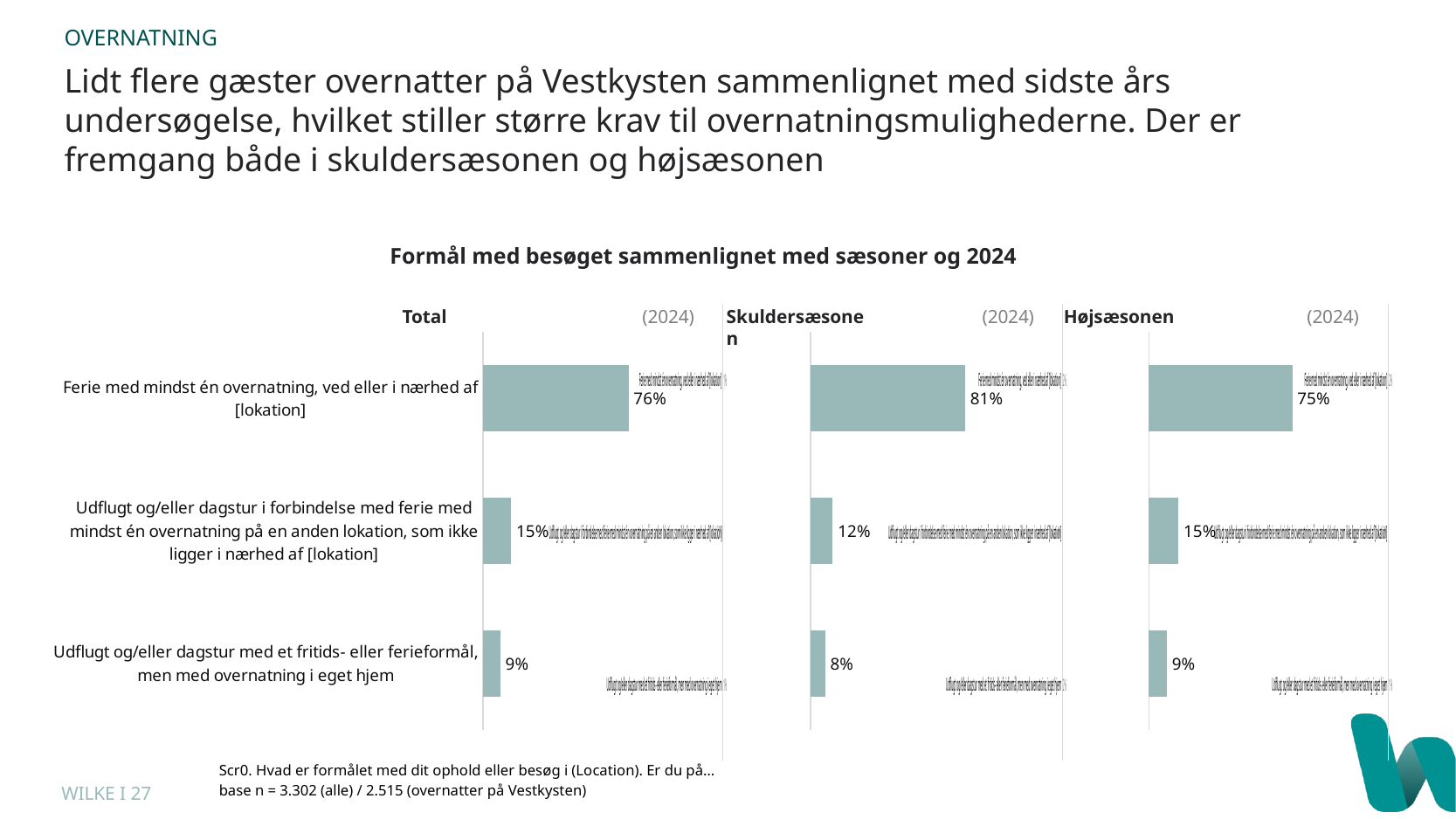
What is the difference between the 'Ferie med mindst én overnatning' value in the Skuldersæsonen chart and in the Højsæsonen chart? 6 percentage points In the Skuldersæsonen chart, which category has the lowest value? Udflugt og/eller dagstur med et fritids- eller ferieformål, men med overnatning i eget hjem Is the 'Ferie med mindst én overnatning' value larger in the Skuldersæsonen chart or in the Total chart? Skuldersæsonen In the Total chart, which category has the highest value? Ferie med mindst én overnatning, ved eller i nærhed af [lokation] In the Højsæsonen chart, what is the value for 'Udflugt og/eller dagstur med et fritids- eller ferieformål, men med overnatning i eget hjem'? 9% In the Total chart, what is the value for 'Ferie med mindst én overnatning, ved eller i nærhed af [lokation]'? 76% What is the title of the chart section on the slide? Formål med besøget sammenlignet med sæsoner og 2024 In the Total chart, what is the difference between the 'Udflugt og/eller dagstur i forbindelse med ferie' value and the 'Udflugt og/eller dagstur med et fritids- eller ferieformål' value? 6 percentage points In the Skuldersæsonen chart, what is the value for 'Udflugt og/eller dagstur i forbindelse med ferie med mindst én overnatning på en anden lokation, som ikke ligger i nærhed af [lokation]'? 12% What type of chart is the Total chart? Bar chart In the Skuldersæsonen chart, what is the value for 'Ferie med mindst én overnatning, ved eller i nærhed af [lokation]'? 81% How many categories are shown in the Højsæsonen chart? 3